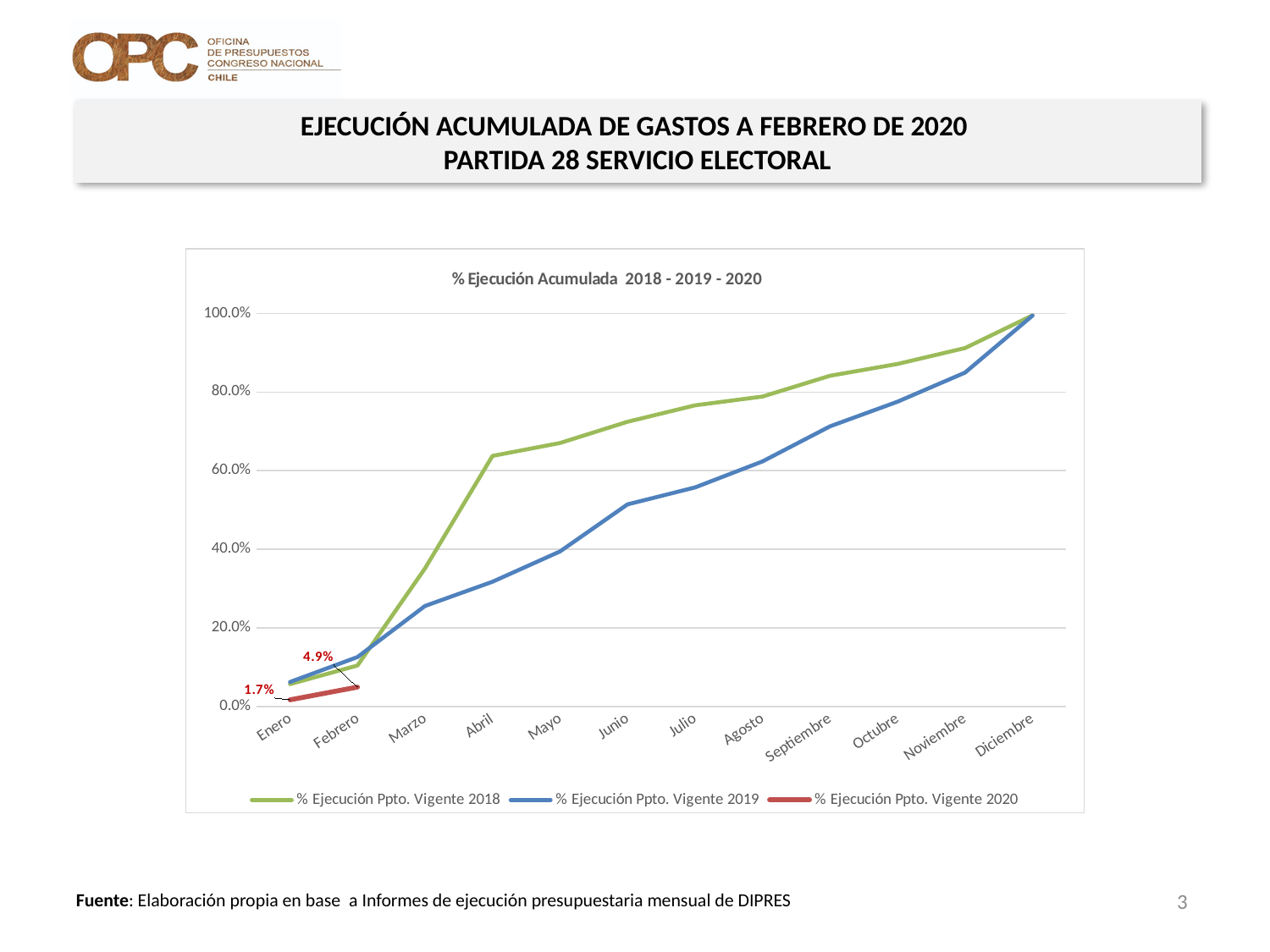
In Abril, which series has the higher value: % Ejecución Ppto. Vigente 2018 or % Ejecución Ppto. Vigente 2019? % Ejecución Ppto. Vigente 2018 Is the value for % Ejecución Ppto. Vigente 2018 in Abril greater or less than 60.0%? greater Is the value for % Ejecución Ppto. Vigente 2019 in Junio greater or less than 40.0%? greater Is the value for % Ejecución Ppto. Vigente 2019 in Noviembre greater or less than 80.0%? greater Does the % Ejecución Ppto. Vigente 2019 line rise or fall from Enero to Diciembre? Rise By how many percentage points did % Ejecución Ppto. Vigente 2020 increase from Enero to Febrero? 3.2 percentage points What is the title of the chart? % Ejecución Acumulada 2018 - 2019 - 2020 How many months are shown along the x axis? 12 What is the value of % Ejecución Ppto. Vigente 2020 for Febrero? 4.9% How many series does the legend list? 3 What kind of chart is shown on the slide? Line chart What is the value of % Ejecución Ppto. Vigente 2020 for Enero? 1.7%